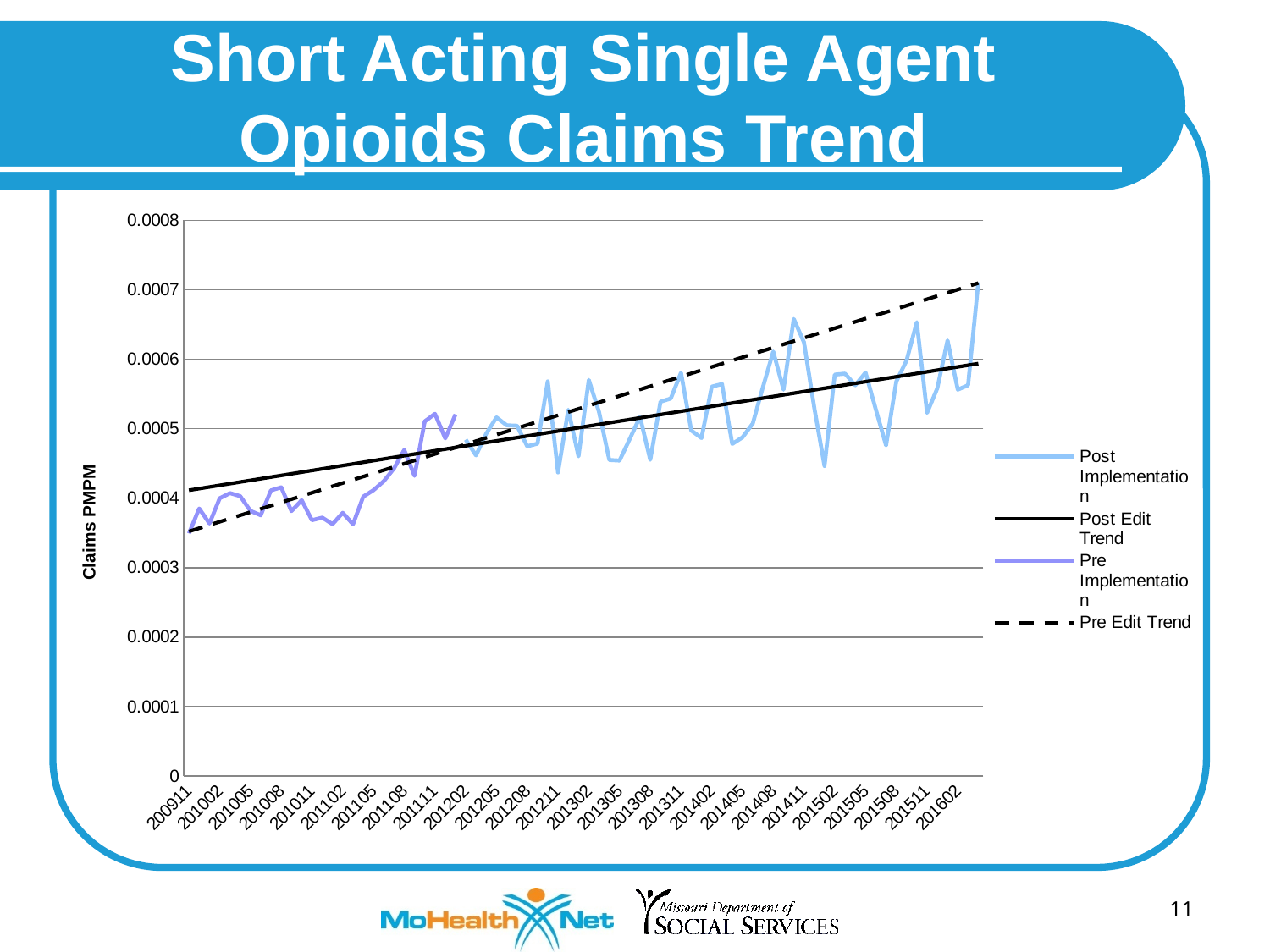
What kind of chart is shown on the slide? line chart Is the highest Post Implementation value greater or less than 0.0006? greater At 200911, which is higher: the Post Edit Trend line or the Pre Edit Trend line? Post Edit Trend What is the title of the vertical axis? Claims PMPM Is the highest Pre Implementation value greater or less than 0.0005? greater Which series is drawn as a dashed line? Pre Edit Trend Does the Pre Edit Trend line rise or fall from left to right? rise At 201602, which is higher: the Pre Edit Trend line or the Post Edit Trend line? Pre Edit Trend Is the Pre Implementation value at 200911 greater or less than 0.0004? less Does the Post Edit Trend line rise or fall from left to right? rise How many series does the legend list? 4